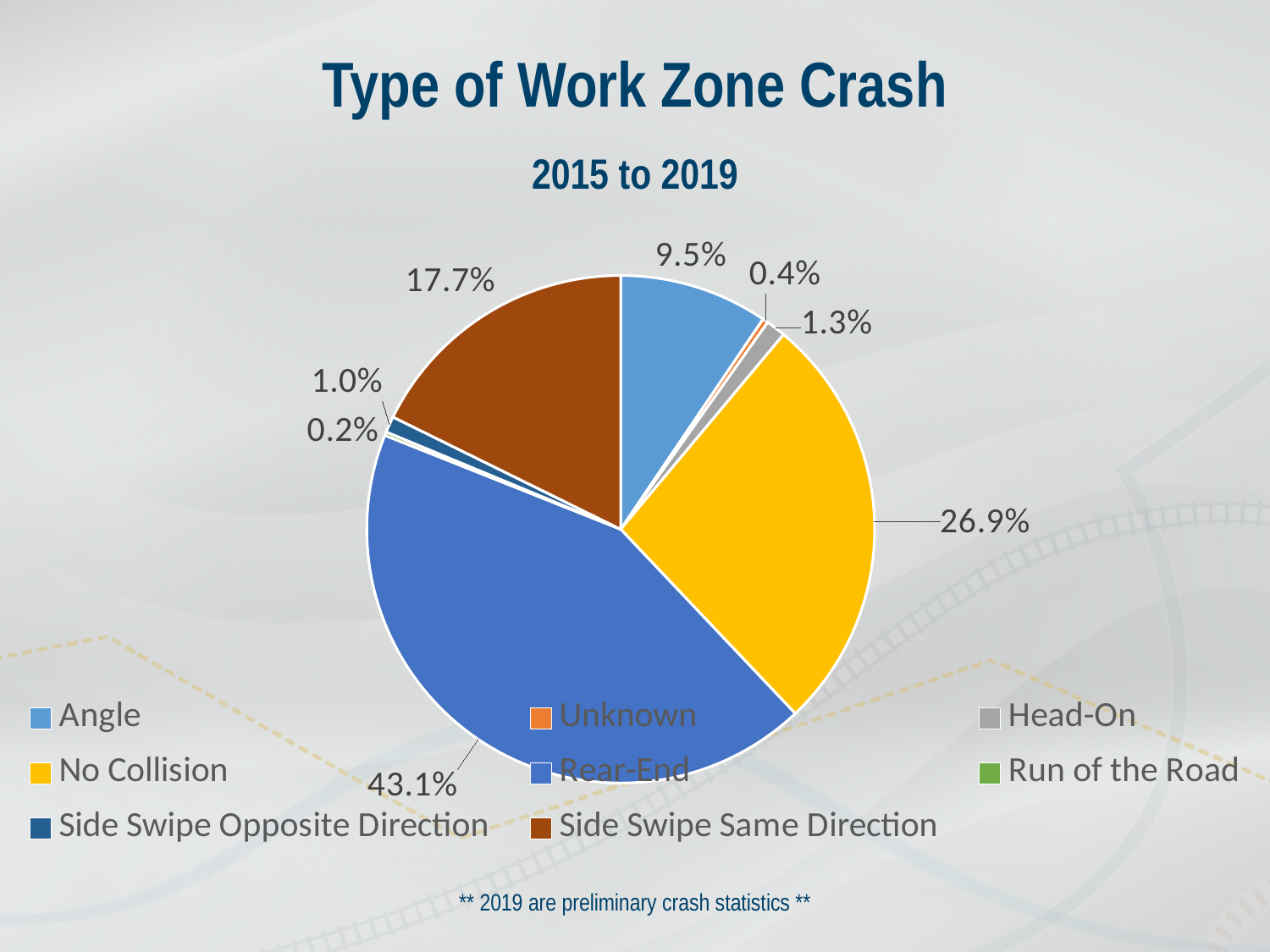
Which is larger, the share of Angle crashes or the share of Side Swipe Same Direction crashes? Side Swipe Same Direction What percentage of work zone crashes are Side Swipe Same Direction? 17.7% What percentage of work zone crashes are Unknown? 0.4% What percentage of work zone crashes are Rear-End? 43.1% How many crash types does the legend list? 8 What years does the chart cover, according to the subtitle? 2015 to 2019 What percentage of work zone crashes are No Collision? 26.9% What percentage of work zone crashes are Head-On? 1.3% Which crash type has the largest share of work zone crashes? Rear-End What percentage of work zone crashes are Angle crashes? 9.5% What type of chart is shown on the slide? Pie chart What is the difference in percentage points between Rear-End and No Collision crashes? 16.2